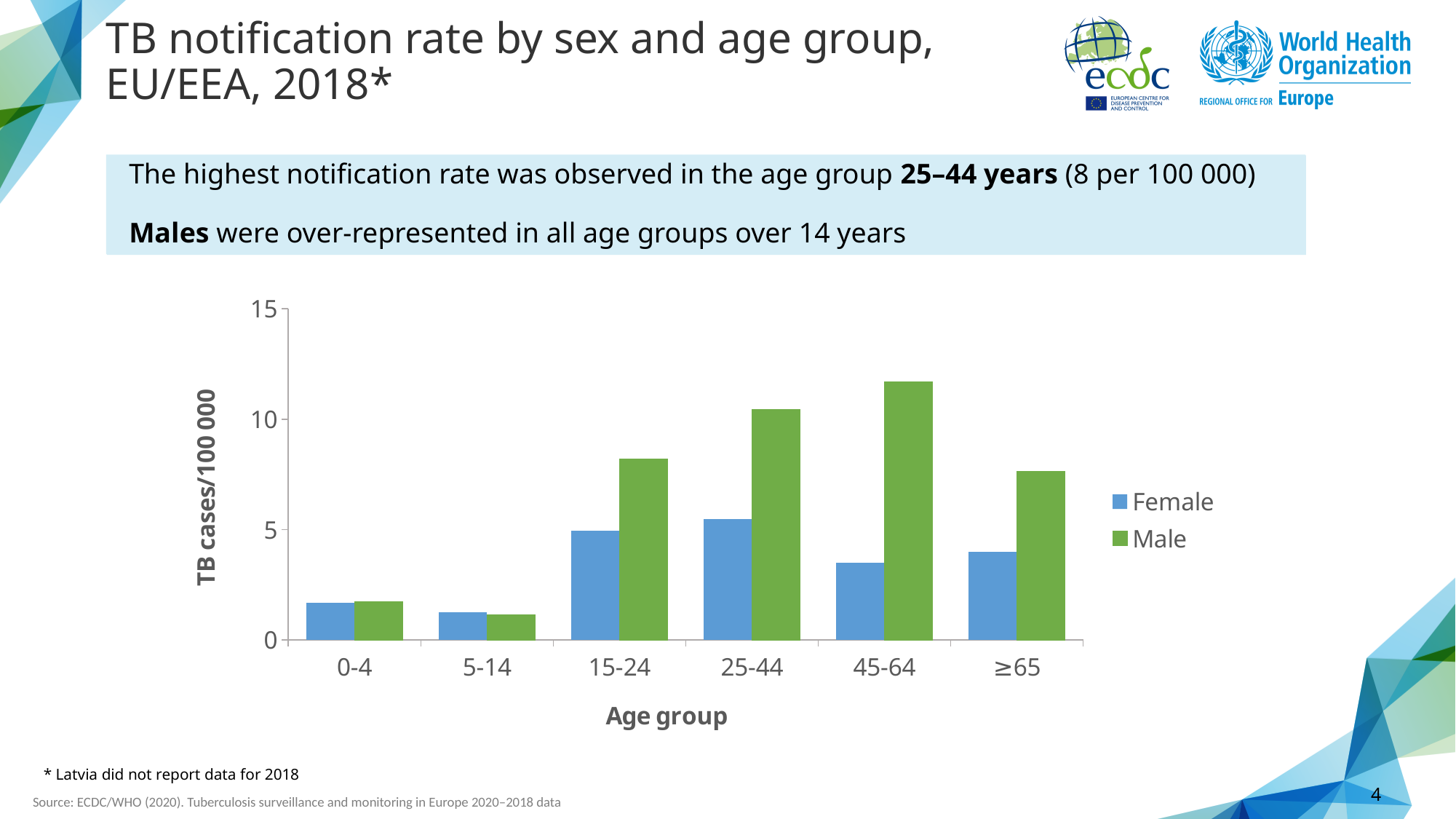
In the 25-44 age group, which is larger, the Female or the Male value? Male What kind of chart is shown on the slide? Bar chart Is the Male value for the 15-24 age group greater or less than 5? greater In the 45-64 age group, which is larger, the Female or the Male value? Male Which age group has the lowest Male TB notification rate? 5-14 Is the Female value for the 45-64 age group greater or less than 5? less Which colour represents the Male series in the chart? Green How many age groups are shown on the x axis of the chart? 6 What is the label of the y axis of the chart? TB cases/100 000 Is the Male value for the 45-64 age group greater or less than 10? greater Which age group has the highest Male TB notification rate? 45-64 How many series does the chart legend list? 2